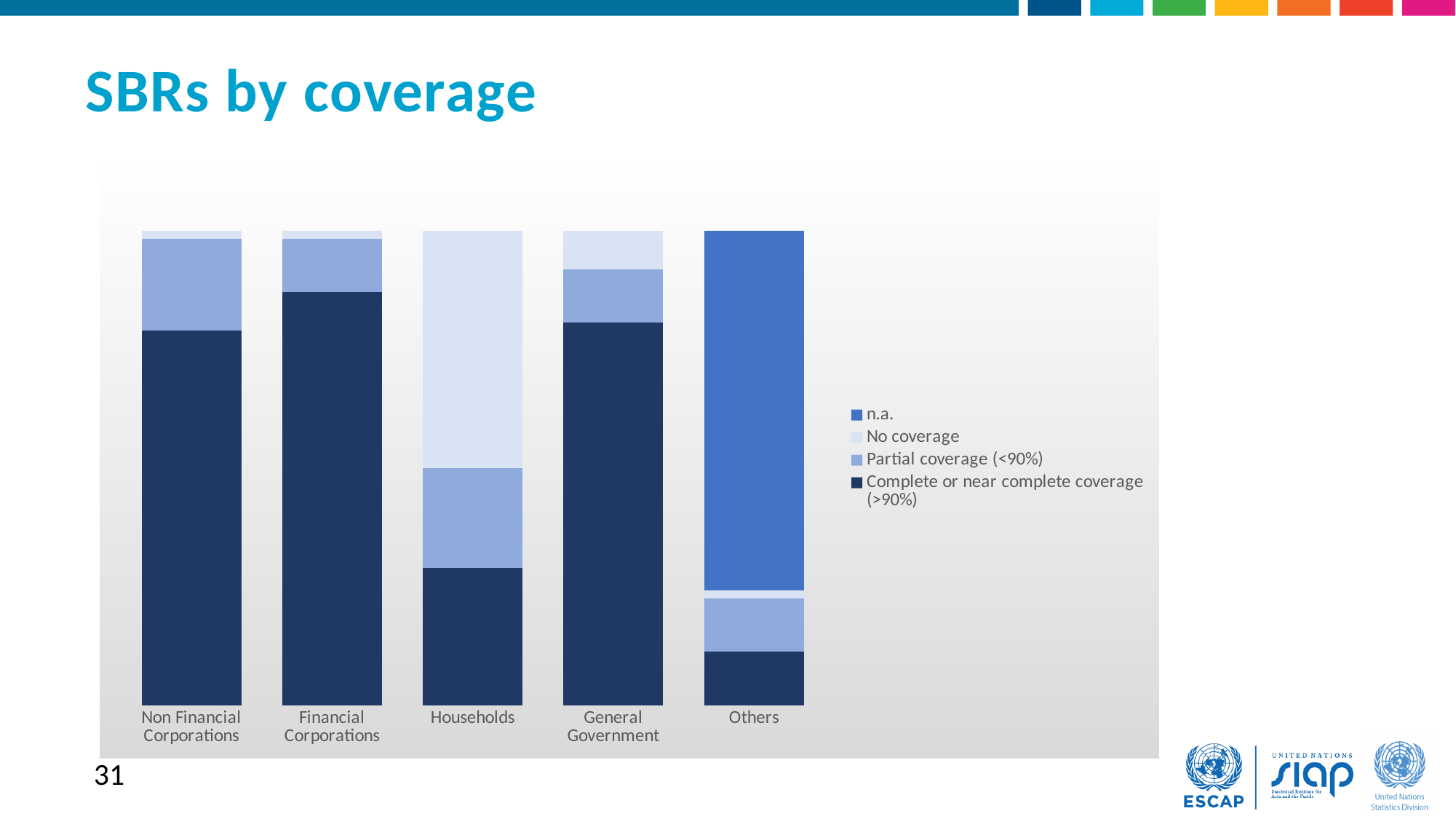
Which has the larger 'Complete or near complete coverage (>90%)' segment, Households or Financial Corporations? Financial Corporations Which category has the largest 'No coverage' segment? Households Which has the larger 'Partial coverage (<90%)' segment, Households or Financial Corporations? Households How many series does the chart's legend list? 4 How many categories are shown along the x axis of the chart? 5 Which has the larger 'No coverage' segment, Households or General Government? Households What is the title of the chart on the slide? SBRs by coverage Which legend entry is shown in the darkest blue colour? Complete or near complete coverage (>90%) Which category has the largest 'Complete or near complete coverage (>90%)' segment? Financial Corporations Which category has the smallest 'Complete or near complete coverage (>90%)' segment? Others Which category has the largest 'n.a.' segment? Others What kind of chart is shown on the slide? Stacked bar chart